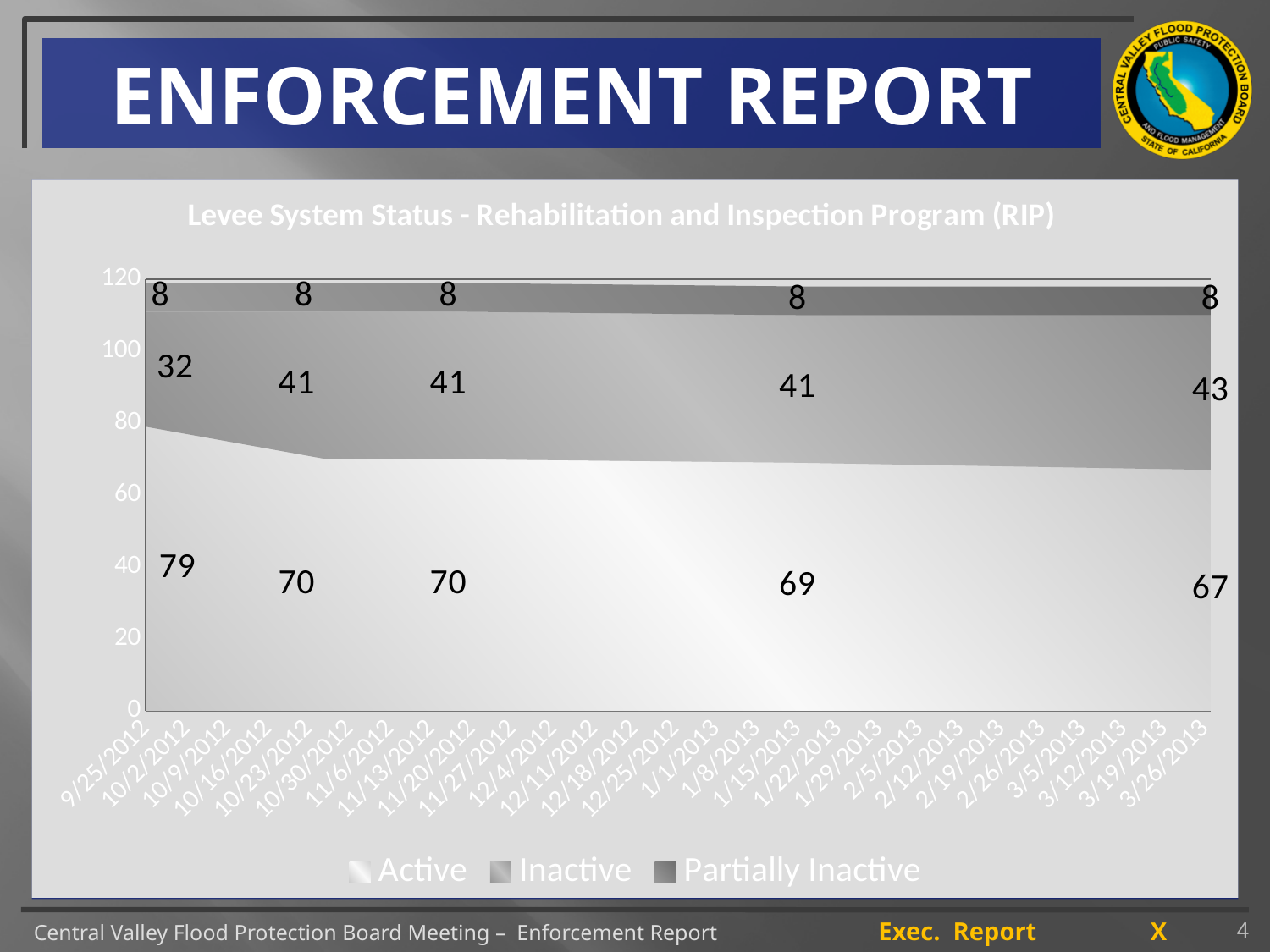
What is the Inactive value at 3/26/2013? 43 How many series does the legend list? 3 What kind of chart is shown on the slide? stacked area chart What is the Active value at 3/26/2013? 67 What is the Active value at 9/25/2012? 79 What are the three series named in the legend? Active, Inactive, Partially Inactive At 3/26/2013, which is larger, the Active value or the Inactive value? Active By how much does the Active value decrease from 9/25/2012 to 3/26/2013? 12 What is the Partially Inactive value at 3/26/2013? 8 What is the Inactive value at 9/25/2012? 32 Does the Active series rise or fall from 9/25/2012 to 3/26/2013? fall What is the total of all three series at 9/25/2012? 119